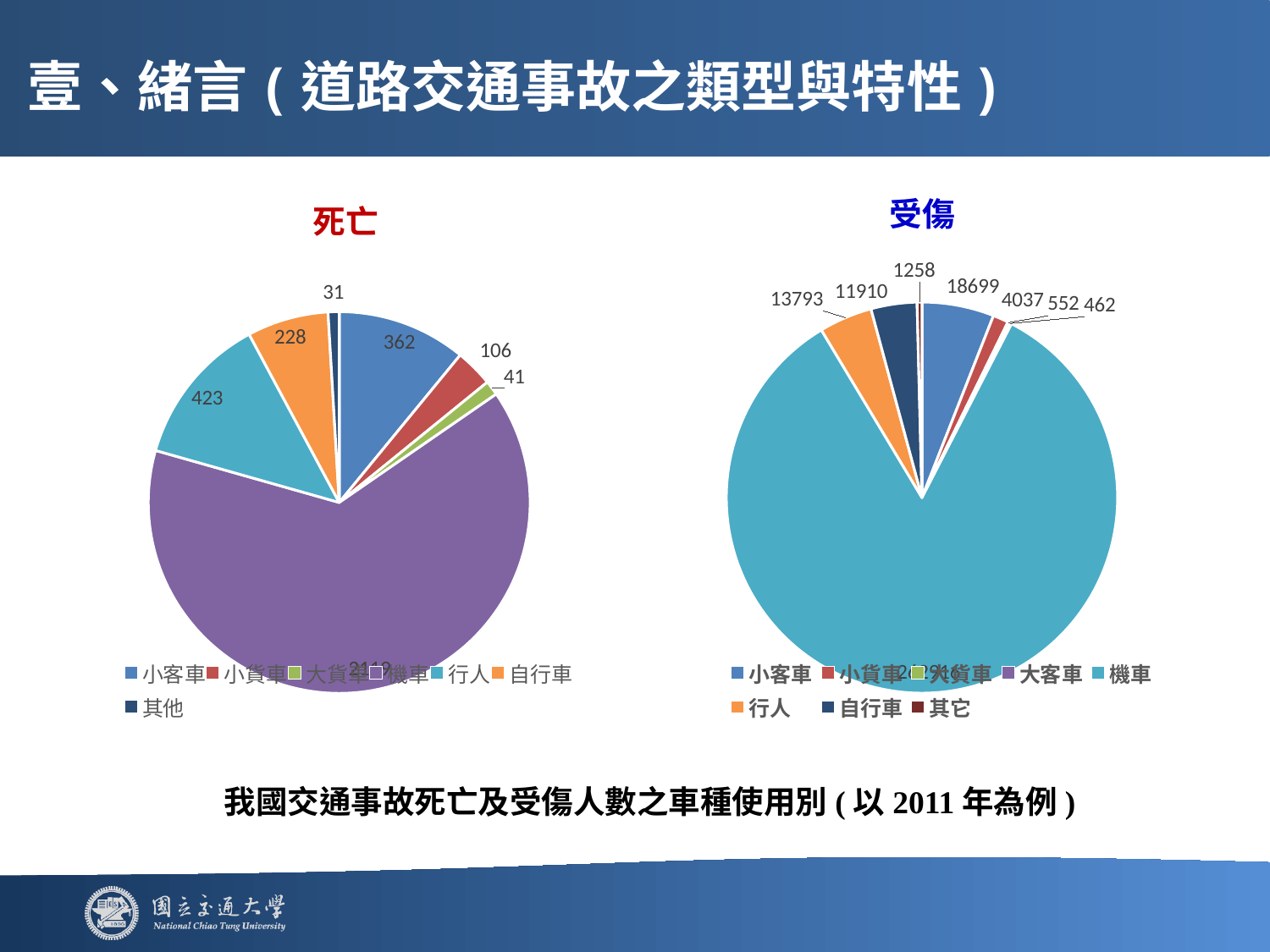
In the 受傷 pie chart, which is larger, the value for 行人 or the value for 自行車? 行人 In the 死亡 pie chart, what is the value for 行人? 423 In the 死亡 pie chart, which category has the largest slice? 機車 In the 死亡 pie chart, what is the value for 小客車? 362 In the 受傷 pie chart, what is the value for 小客車? 18699 In the 受傷 pie chart, which category has the largest slice? 機車 What kind of chart is used for the 死亡 data? Pie chart In the 受傷 pie chart, what is the value for 行人? 13793 In the 死亡 pie chart, which category has the smallest value? 其他 In the 死亡 pie chart, what is the value for 其他? 31 How many categories does the legend of the 受傷 pie chart list? 8 In the 死亡 pie chart, what is the difference between the values for 行人 and 小客車? 61